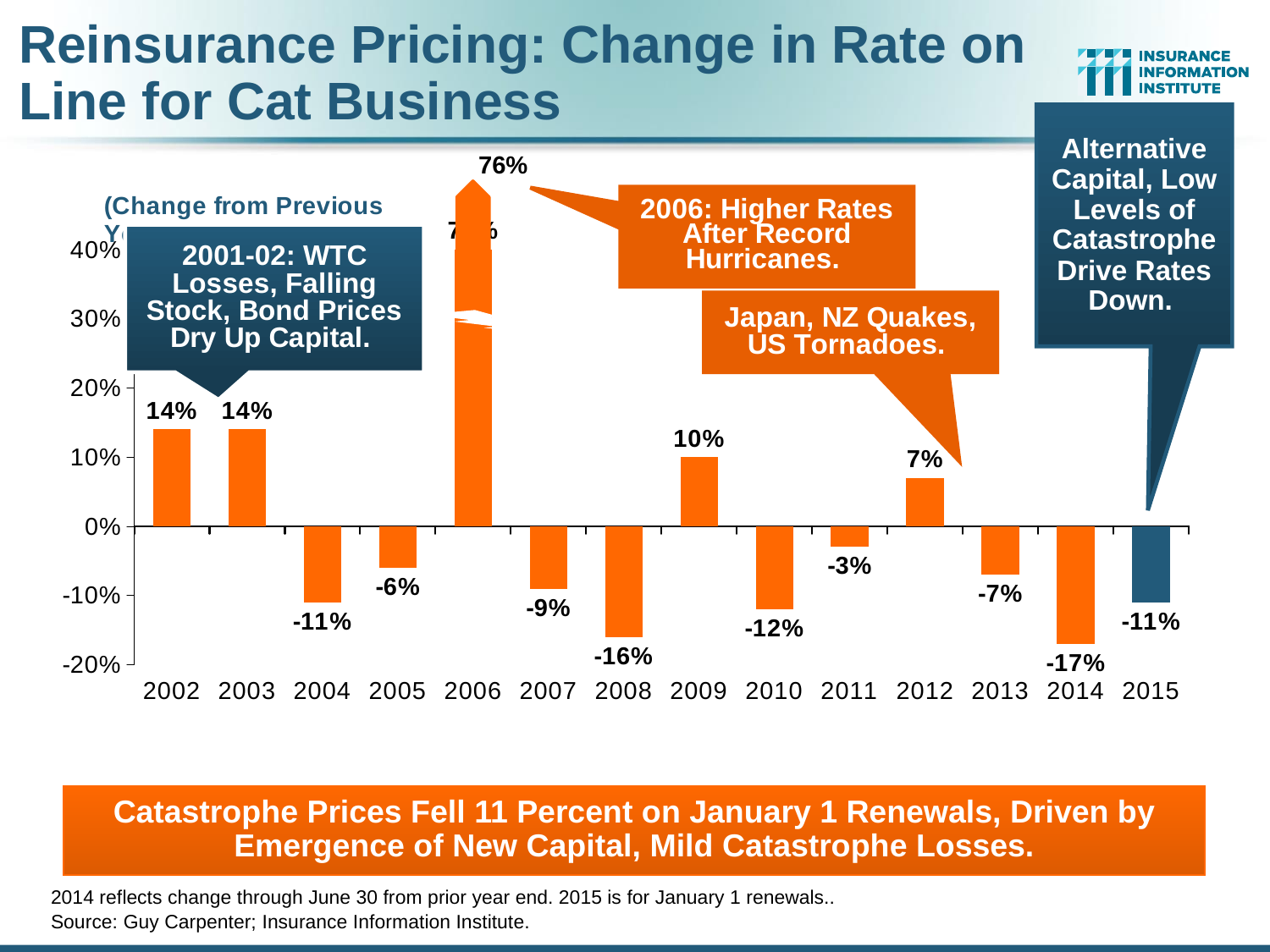
What value is shown for 2014? -17% What is the difference between the values for 2002 and 2012? 7 percentage points What value is shown for 2011? -3% What is the change in rate on line for cat business shown for 2009? 10% Which year has the lowest change in rate on line? 2014 Which year's bar is shown in a different colour (blue) from the rest? 2015 What value is shown for 2015? -11% Is the value for 2006 greater or less than 40%? greater What type of chart is shown on the slide? Bar chart Which year has the larger value, 2008 or 2010? 2010 Which year has the highest change in rate on line? 2006 How many years are plotted on the chart? 14